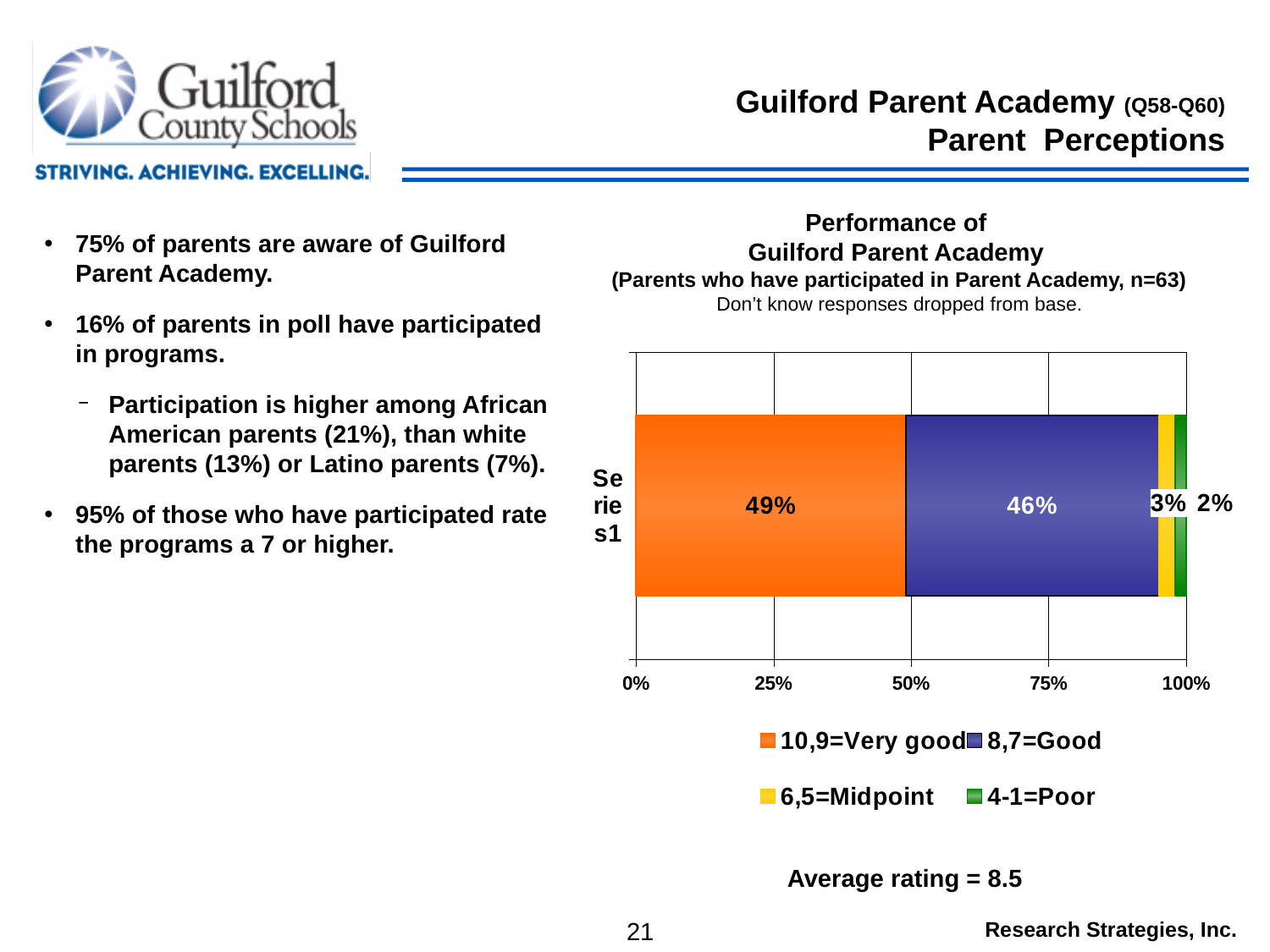
What type of chart is shown on the slide? Stacked bar chart What is the difference between the 10,9=Very good share and the 8,7=Good share? 3% Which is larger, the 6,5=Midpoint share or the 4-1=Poor share? 6,5=Midpoint What is the average rating stated below the chart? 8.5 Which rating category has the largest share of the bar? 10,9=Very good What percentage of parents rated Guilford Parent Academy as 10,9=Very good? 49% What percentage of parents rated Guilford Parent Academy as 8,7=Good? 46% How many series does the chart legend list? 4 Which rating category has the smallest share of the bar? 4-1=Poor What percentage of parents gave a 6,5=Midpoint rating? 3% What is the combined share of 10,9=Very good and 8,7=Good ratings? 95% What percentage of parents gave a 4-1=Poor rating? 2%